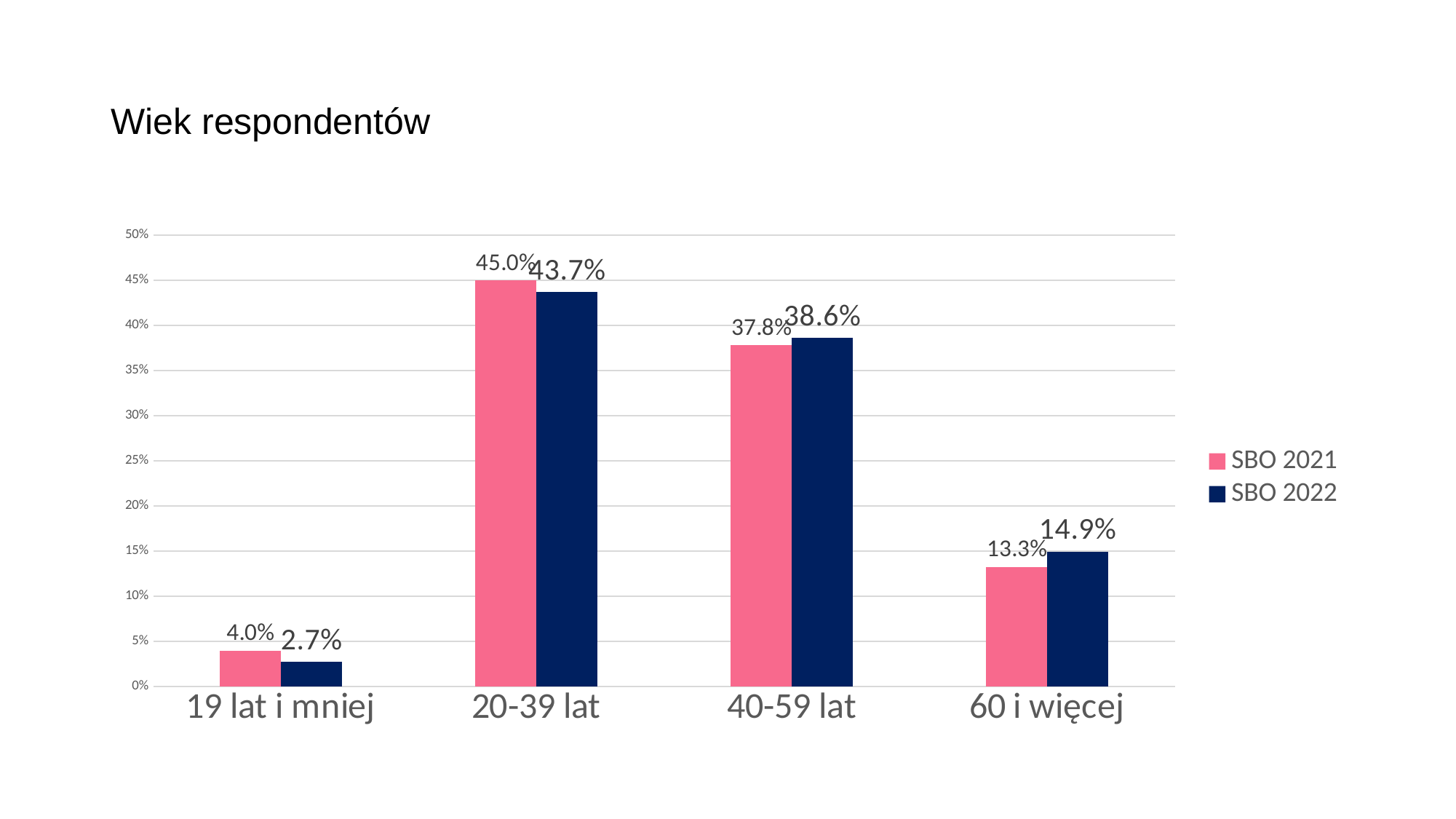
What is the difference between SBO 2021 and SBO 2022 in the 40-59 lat category? 0.8% Which age category has the lowest value for SBO 2021? 19 lat i mniej Which age category has the highest value for SBO 2022? 20-39 lat Is the value for SBO 2021 in the 40-59 lat category greater or less than 40%? less What is the title of the slide? Wiek respondentów How many series does the legend list? 2 What is the value for SBO 2021 in the 20-39 lat category? 45.0% What is the value for SBO 2022 in the 60 i więcej category? 14.9% What kind of chart is shown on the slide? bar chart What is the value for SBO 2022 in the 19 lat i mniej category? 2.7% How many age categories are shown on the x axis? 4 Which is larger in the 60 i więcej category, SBO 2021 or SBO 2022? SBO 2022